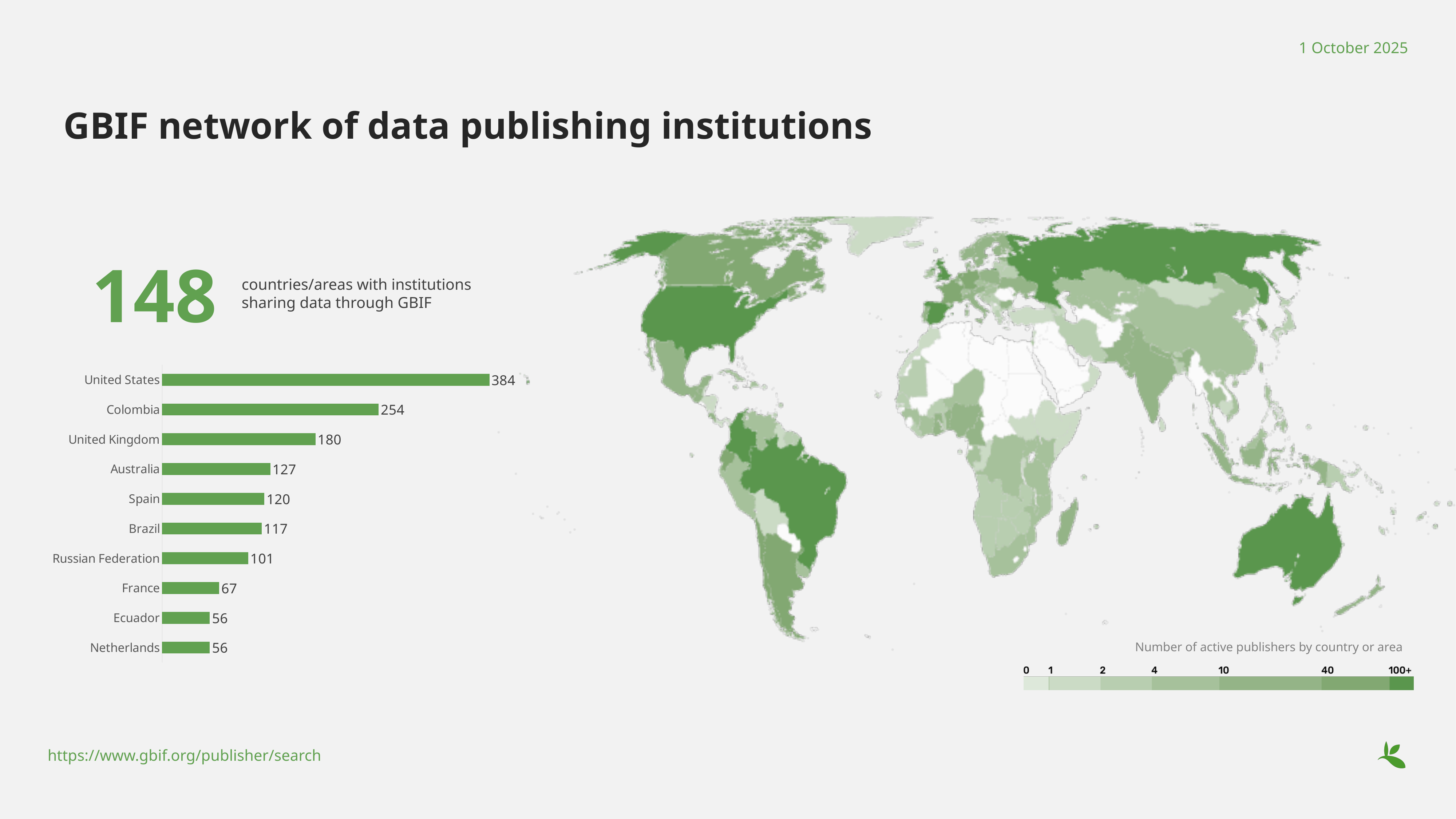
In the bar chart, what is the value for Colombia? 254 In the bar chart, which is larger, Spain or Brazil? Spain In the bar chart, which country has the highest value? United States In the bar chart, how many publishers does the United States have? 384 What is the highest value shown on the map's colour legend? 100+ In the bar chart, what is the value for the Russian Federation? 101 In the bar chart, which is larger, France or Ecuador? France In the bar chart, what is the difference between the United Kingdom and Australia? 53 What kind of chart is on the left of the slide? bar chart In the bar chart, what is the difference between the United States and Colombia? 130 In the bar chart, what is the value for the Netherlands? 56 How many countries are shown in the bar chart? 10